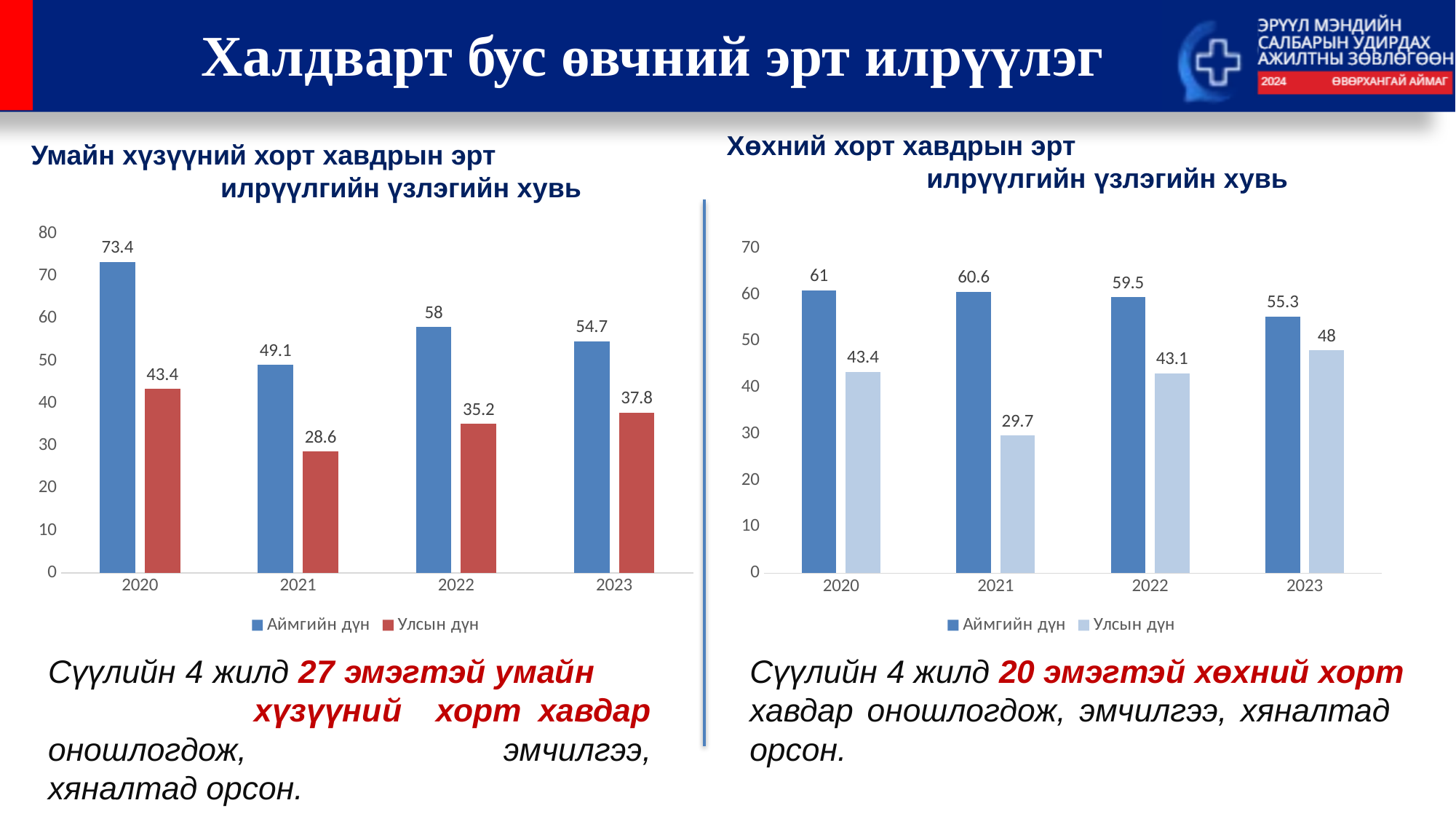
In the right chart (Хөхний хорт хавдрын эрт илрүүлгийн үзлэгийн хувь), what is the Аймгийн дүн value for 2023? 55.3 In the right chart (Хөхний хорт хавдрын эрт илрүүлгийн үзлэгийн хувь), what is the Улсын дүн value for 2021? 29.7 In the left chart (Умайн хүзүүний хорт хавдрын эрт илрүүлгийн үзлэгийн хувь), what is the difference between the Аймгийн дүн and Улсын дүн values for 2022? 22.8 In the left chart (Умайн хүзүүний хорт хавдрын эрт илрүүлгийн үзлэгийн хувь), what is the Аймгийн дүн value for 2020? 73.4 In the right chart (Хөхний хорт хавдрын эрт илрүүлгийн үзлэгийн хувь), does the Аймгийн дүн value rise or fall from 2020 to 2023? fall In the left chart (Умайн хүзүүний хорт хавдрын эрт илрүүлгийн үзлэгийн хувь), what is the Улсын дүн value for 2021? 28.6 In the right chart (Хөхний хорт хавдрын эрт илрүүлгийн үзлэгийн хувь), which year has the highest Улсын дүн value? 2023 In the right chart (Хөхний хорт хавдрын эрт илрүүлгийн үзлэгийн хувь), which is larger: the Улсын дүн value for 2020 or for 2021? 2020 How many series does the legend of the left chart (Умайн хүзүүний хорт хавдрын эрт илрүүлгийн үзлэгийн хувь) list? 2 What kind of chart is the right chart (Хөхний хорт хавдрын эрт илрүүлгийн үзлэгийн хувь)? bar chart In the left chart (Умайн хүзүүний хорт хавдрын эрт илрүүлгийн үзлэгийн хувь), which year has the highest Аймгийн дүн value? 2020 In the left chart (Умайн хүзүүний хорт хавдрын эрт илрүүлгийн үзлэгийн хувь), which year has the lowest Улсын дүн value? 2021